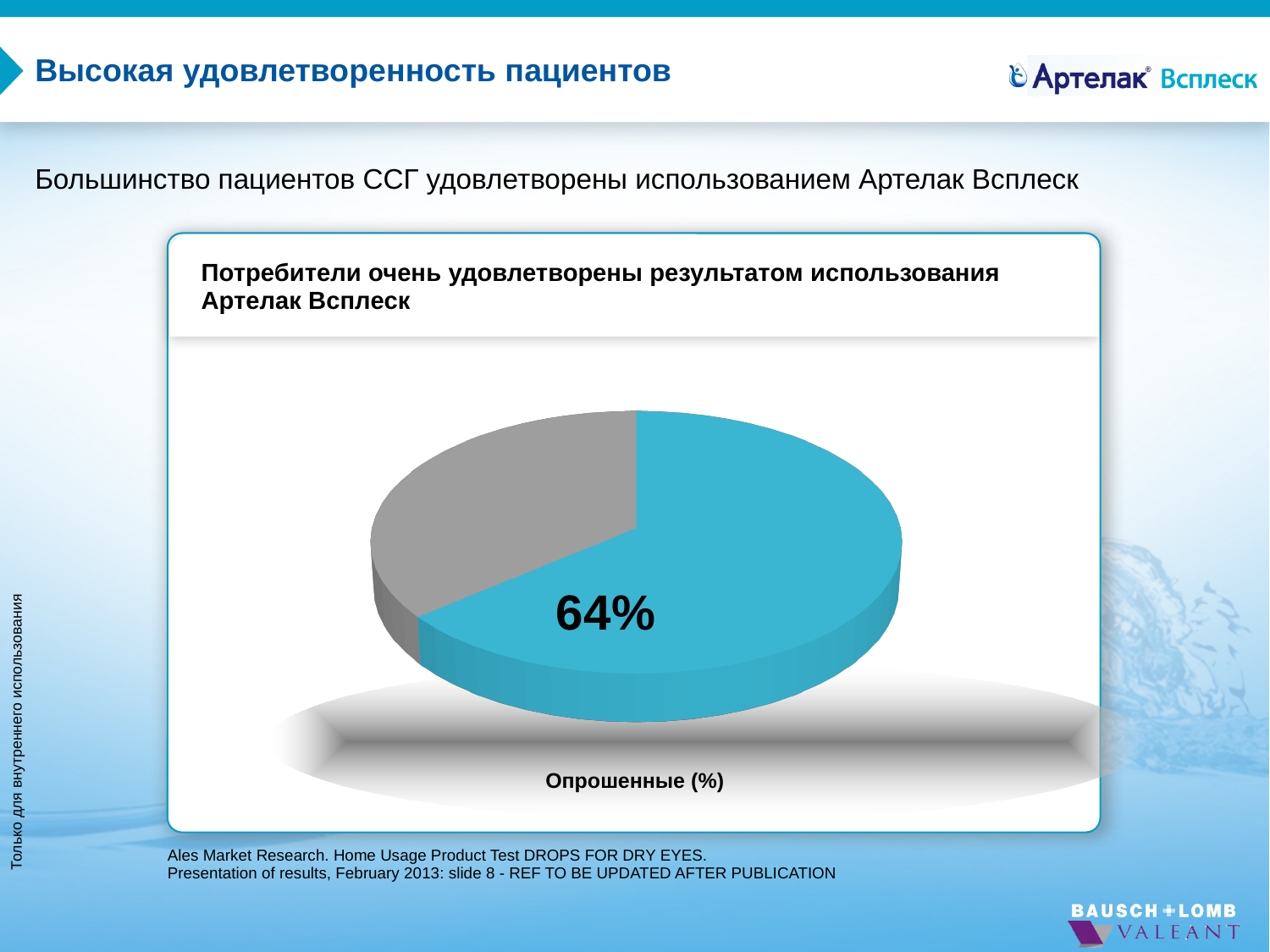
Which slice of the pie chart is larger, the blue one or the grey one? the blue one What percentage is printed on the blue slice of the pie chart? 64% Is the grey slice of the pie chart greater or less than 50% of the pie? less What kind of chart is shown on the slide? pie chart Is the blue slice of the pie chart greater or less than 50% of the pie? greater What is the title of the chart? Потребители очень удовлетворены результатом использования Артелак Всплеск What share of the pie does the blue slice represent? 64% How many slices does the pie chart have? 2 What label appears below the pie chart? Опрошенные (%)